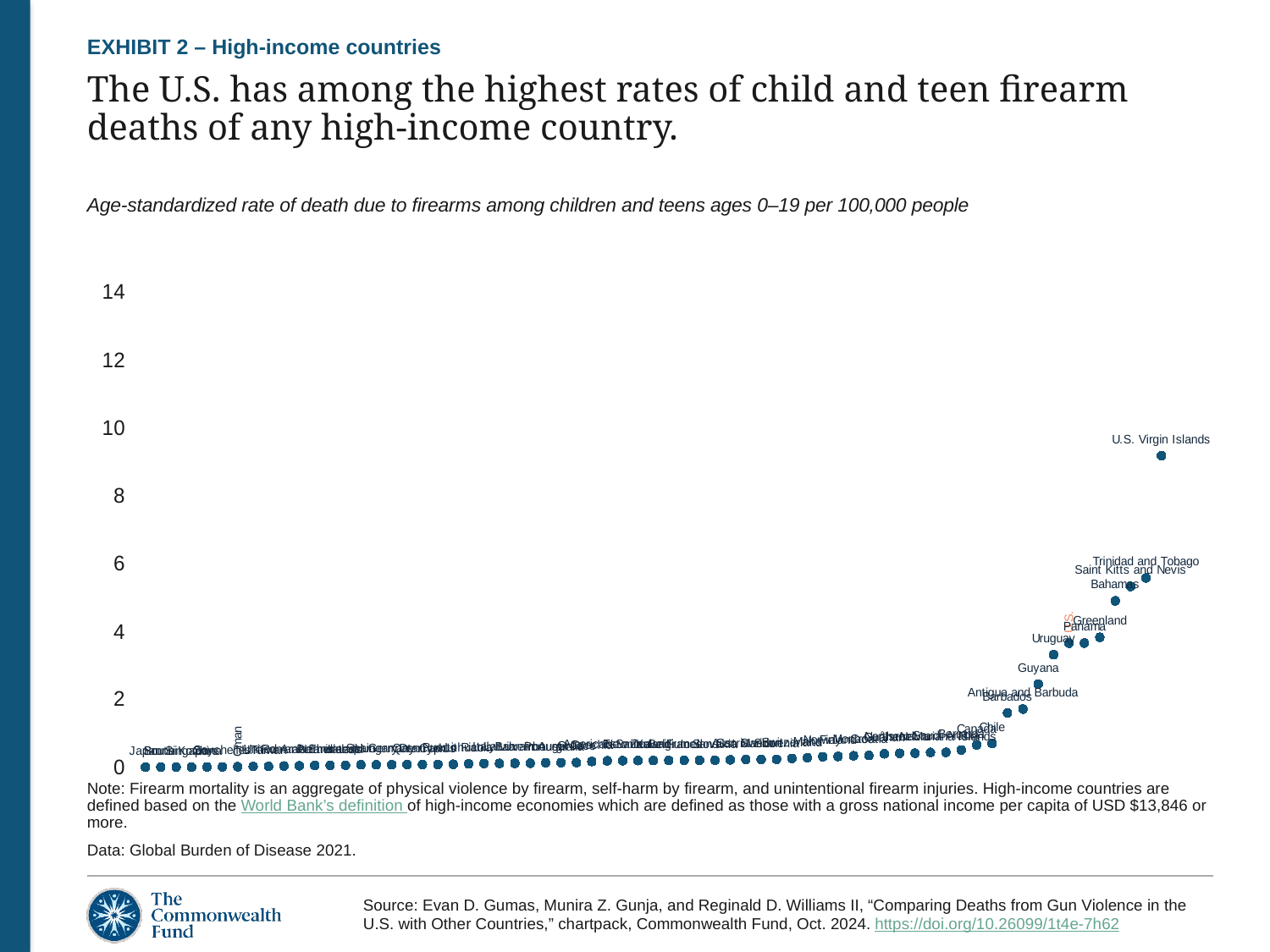
Is the value for Guyana greater or less than 4? less Is the value for U.S. Virgin Islands greater or less than 8? greater Is the value for U.S. Virgin Islands greater or less than 10? less Which country has the highest rate of child and teen firearm deaths on the chart? U.S. Virgin Islands What kind of chart is shown on the slide? Scatter chart Do the values rise or fall moving from left to right along the x axis? Rise What measure does the chart plot, according to the subtitle? Age-standardized rate of death due to firearms among children and teens ages 0–19 per 100,000 people Which has a higher rate, Guyana or Uruguay? Uruguay Which has a higher rate, U.S. Virgin Islands or Bahamas? U.S. Virgin Islands